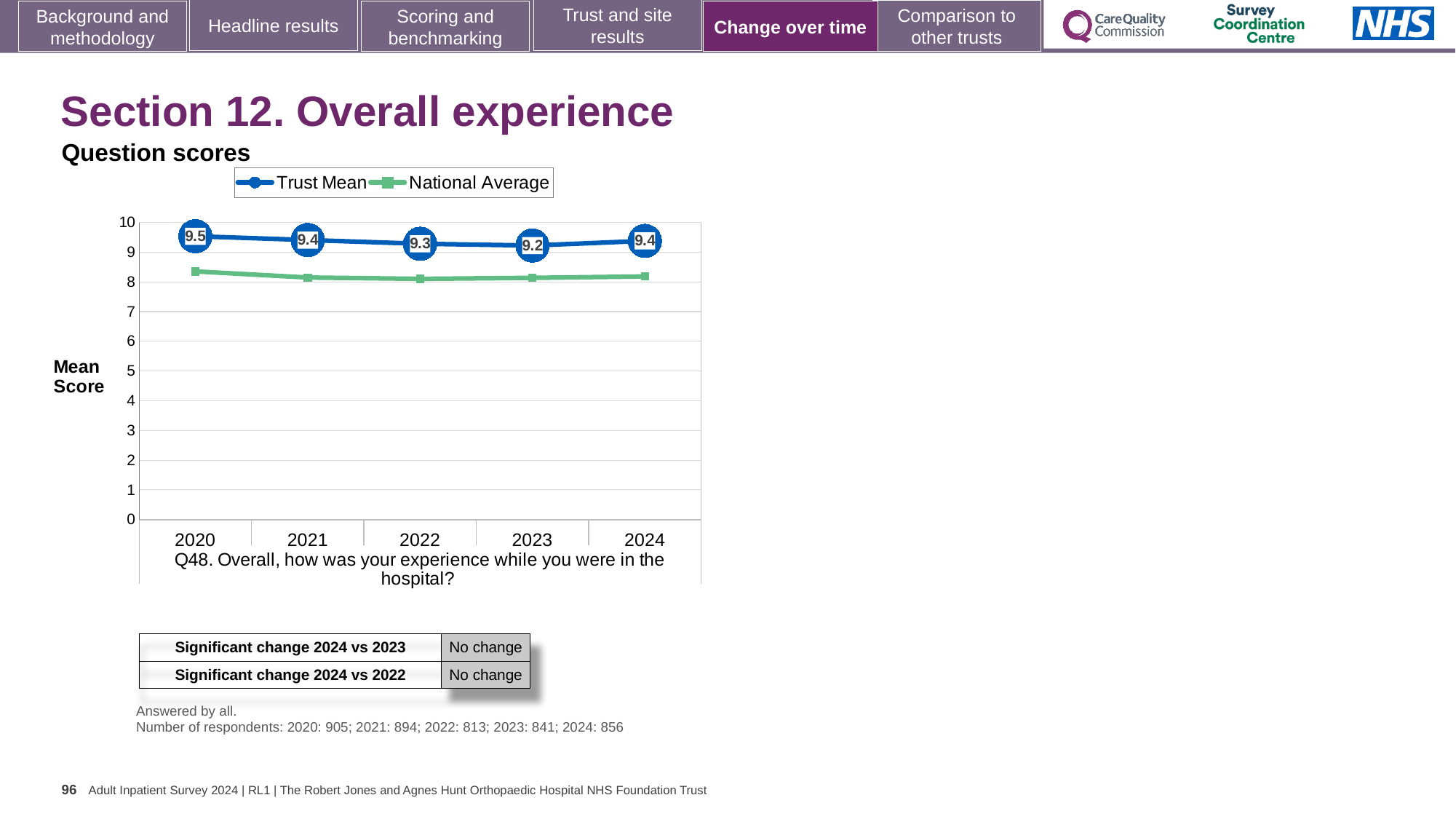
Is the National Average value for 2022 greater or less than 9? less What is the Trust Mean score for 2024? 9.4 Which is larger, the Trust Mean score in 2021 or in 2023? 2021 In which year is the Trust Mean score lowest? 2023 How many years are shown on the x axis of the chart? 5 Which series is plotted in green in the chart? National Average In which year is the Trust Mean score highest? 2020 How many series does the chart legend list? 2 What kind of chart is shown on the slide? line chart What is the Trust Mean score for 2020? 9.5 What is the difference between the Trust Mean score in 2020 and in 2023? 0.3 What is the Trust Mean score for 2023? 9.2